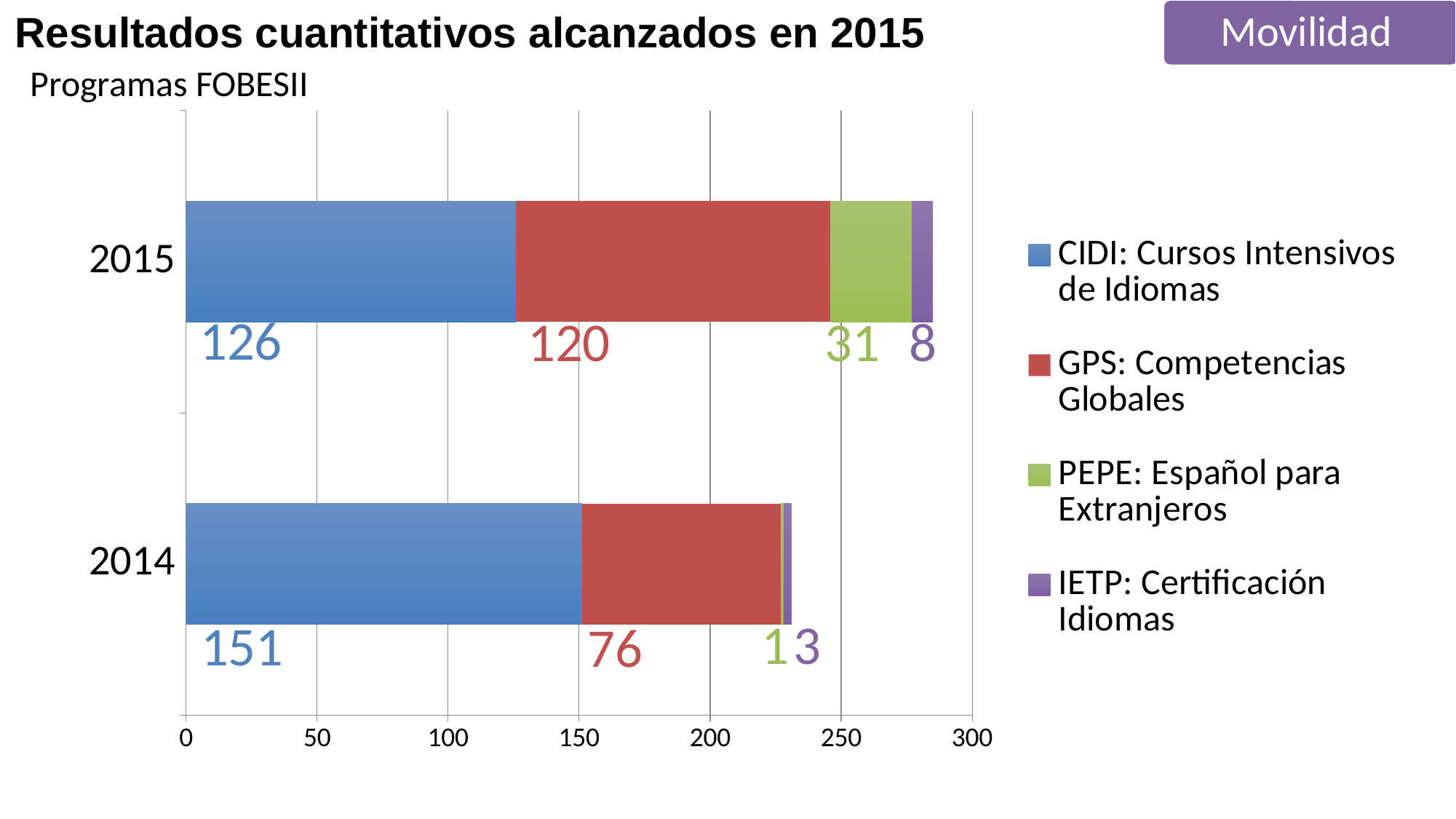
Which year has the higher value for CIDI: Cursos Intensivos de Idiomas, 2014 or 2015? 2014 What is the value for PEPE: Español para Extranjeros in 2015? 31 What is the difference between the GPS: Competencias Globales values for 2015 and 2014? 44 How many series does the legend list? 4 What is the value for CIDI: Cursos Intensivos de Idiomas in 2015? 126 What is the value for IETP: Certificación Idiomas in 2015? 8 What is the value for GPS: Competencias Globales in 2014? 76 What is the total of the stacked bar for 2015? 285 What kind of chart is shown on the slide? stacked bar chart Is the total of the stacked bar for 2014 greater or less than 250? less Which colour represents GPS: Competencias Globales in the chart? red How many categories (years) are shown on the chart? 2